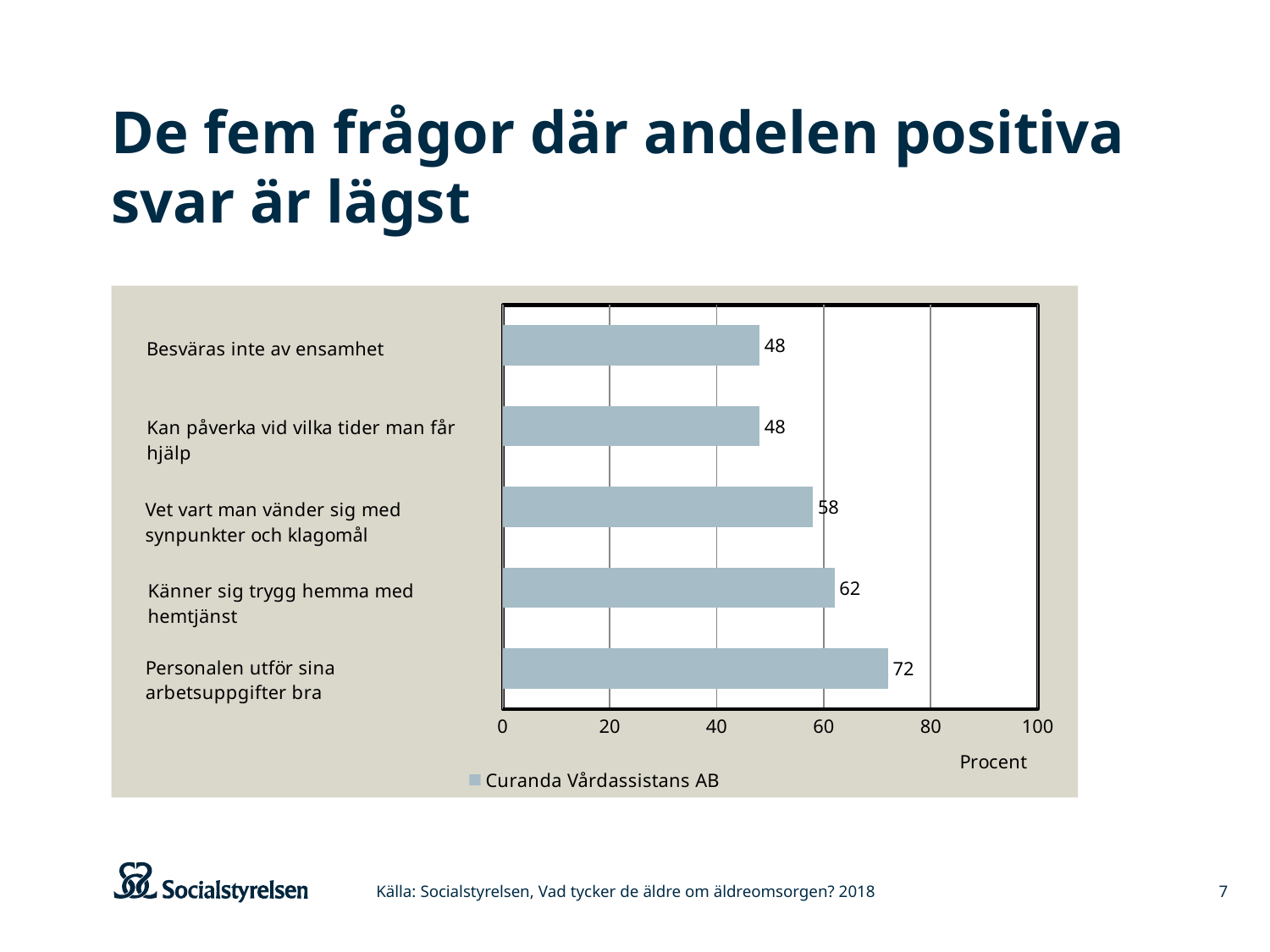
What is the value for "Besväras inte av ensamhet"? 48 What series name does the legend show? Curanda Vårdassistans AB Which is larger, the value for "Känner sig trygg hemma med hemtjänst" or the value for "Vet vart man vänder sig med synpunkter och klagomål"? Känner sig trygg hemma med hemtjänst What is the value for "Känner sig trygg hemma med hemtjänst"? 62 What is the value for "Vet vart man vänder sig med synpunkter och klagomål"? 58 What kind of chart is shown on the slide? bar chart What is the difference between the values for "Personalen utför sina arbetsuppgifter bra" and "Känner sig trygg hemma med hemtjänst"? 10 How many categories are shown in the chart? 5 What is the difference between the values for "Vet vart man vänder sig med synpunkter och klagomål" and "Kan påverka vid vilka tider man får hjälp"? 10 Is the value for "Personalen utför sina arbetsuppgifter bra" greater or less than 60? greater Which category has the highest value? Personalen utför sina arbetsuppgifter bra What is the value for "Personalen utför sina arbetsuppgifter bra"? 72